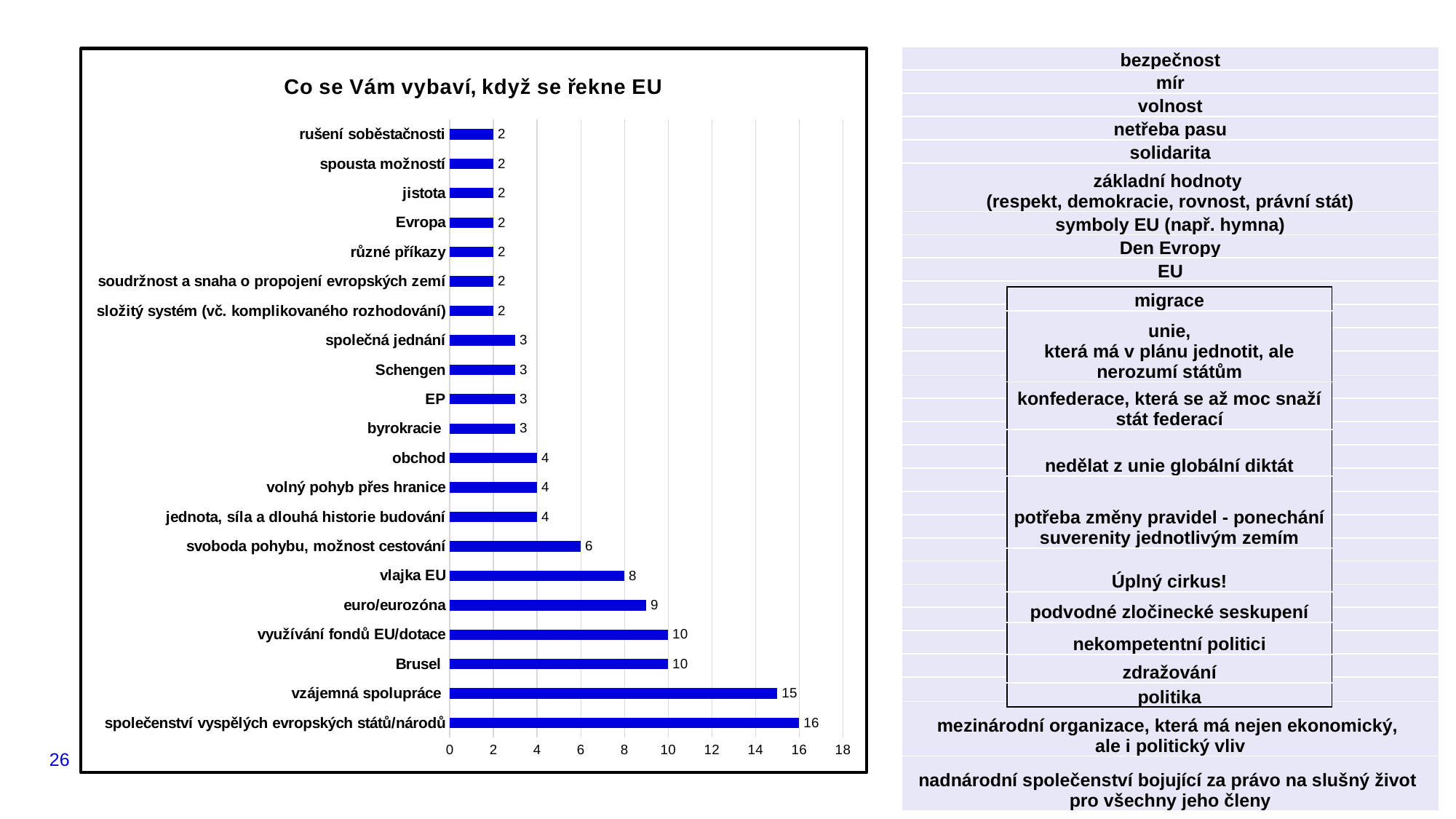
How many categories are shown in the chart? 21 Which is larger, the value for "vlajka EU" or the value for "obchod"? vlajka EU What is the value for "euro/eurozóna"? 9 What is the difference between the values for "společenství vyspělých evropských států/národů" and "vzájemná spolupráce"? 1 What is the difference between the values for "Brusel" and "vlajka EU"? 2 What is the value for "svoboda pohybu, možnost cestování"? 6 What is the title of the chart? Co se Vám vybaví, když se řekne EU What kind of chart is shown on the slide? bar chart What is the value for "Schengen"? 3 What is the value for "vzájemná spolupráce"? 15 Which category has the highest value? společenství vyspělých evropských států/národů Is the value for "využívání fondů EU/dotace" greater or less than 8? greater